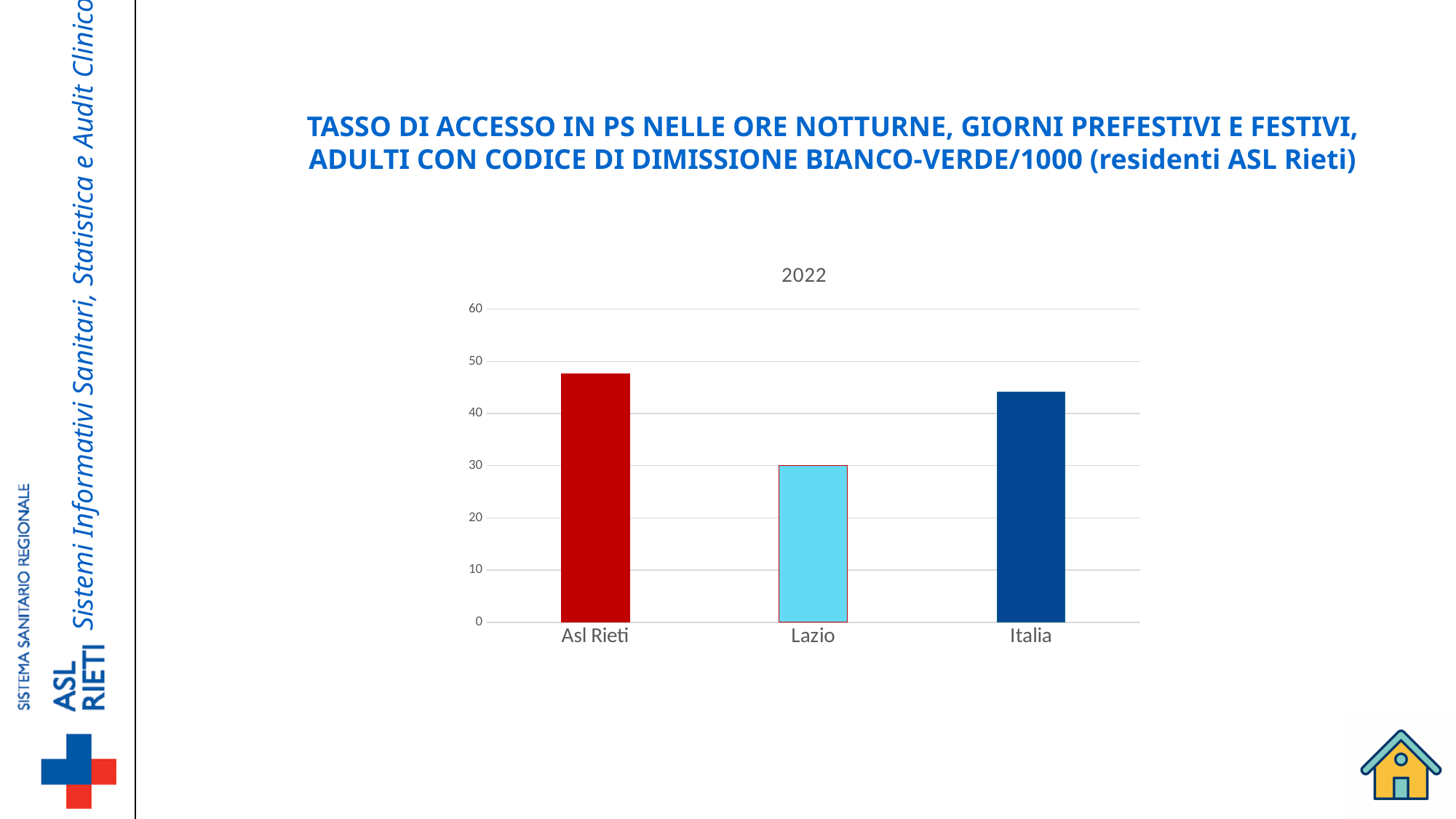
What title is shown directly above the chart's plot area? 2022 How many categories are plotted on the chart? 3 Is the value for Asl Rieti greater or less than 40? greater Is the value for Lazio greater or less than 40? less What kind of chart is shown on the slide? bar chart Is the value for Asl Rieti greater or less than 50? less Which is larger, the value for Asl Rieti or the value for Italia? Asl Rieti Which category has the lowest value? Lazio Which category has the highest value? Asl Rieti What colour is the bar for Lazio? light blue Which is larger, the value for Lazio or the value for Italia? Italia